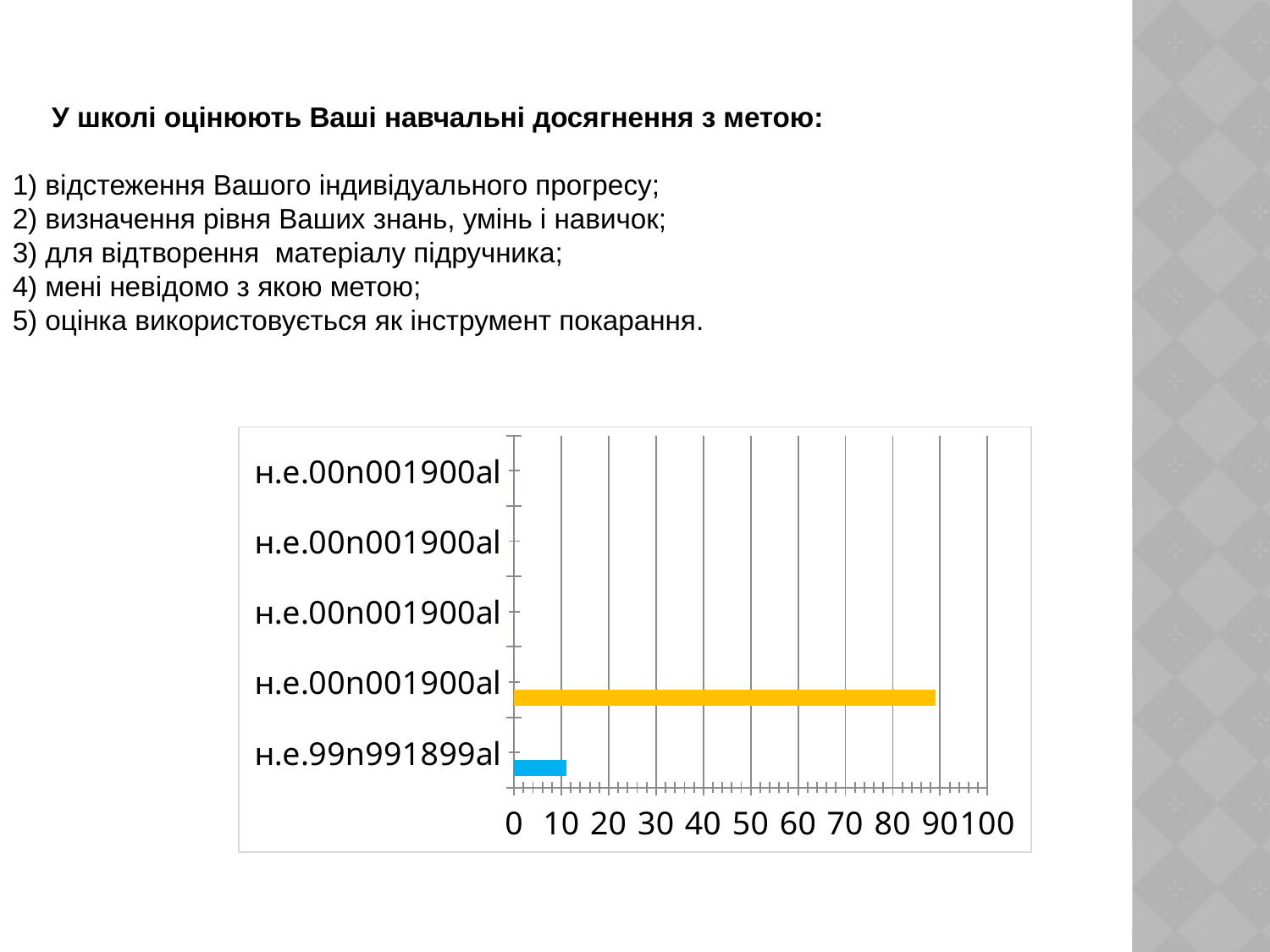
How many bars with a visible length are plotted in the chart? 2 Is the value of the orange bar greater or less than 50? greater Which category has the highest value in the chart? the second category from the bottom (orange bar) Which bar is longer, the orange bar or the blue bar? the orange bar What kind of chart is shown on the slide? bar chart Is the value of the blue bar (bottom category) greater or less than 20? less How many categories are listed on the vertical axis of the chart? 5 What is the highest value shown on the horizontal axis of the chart? 100 What is the interval between the labelled ticks on the horizontal axis? 10 Is the value of the orange bar (second from the bottom) greater or less than 80? greater